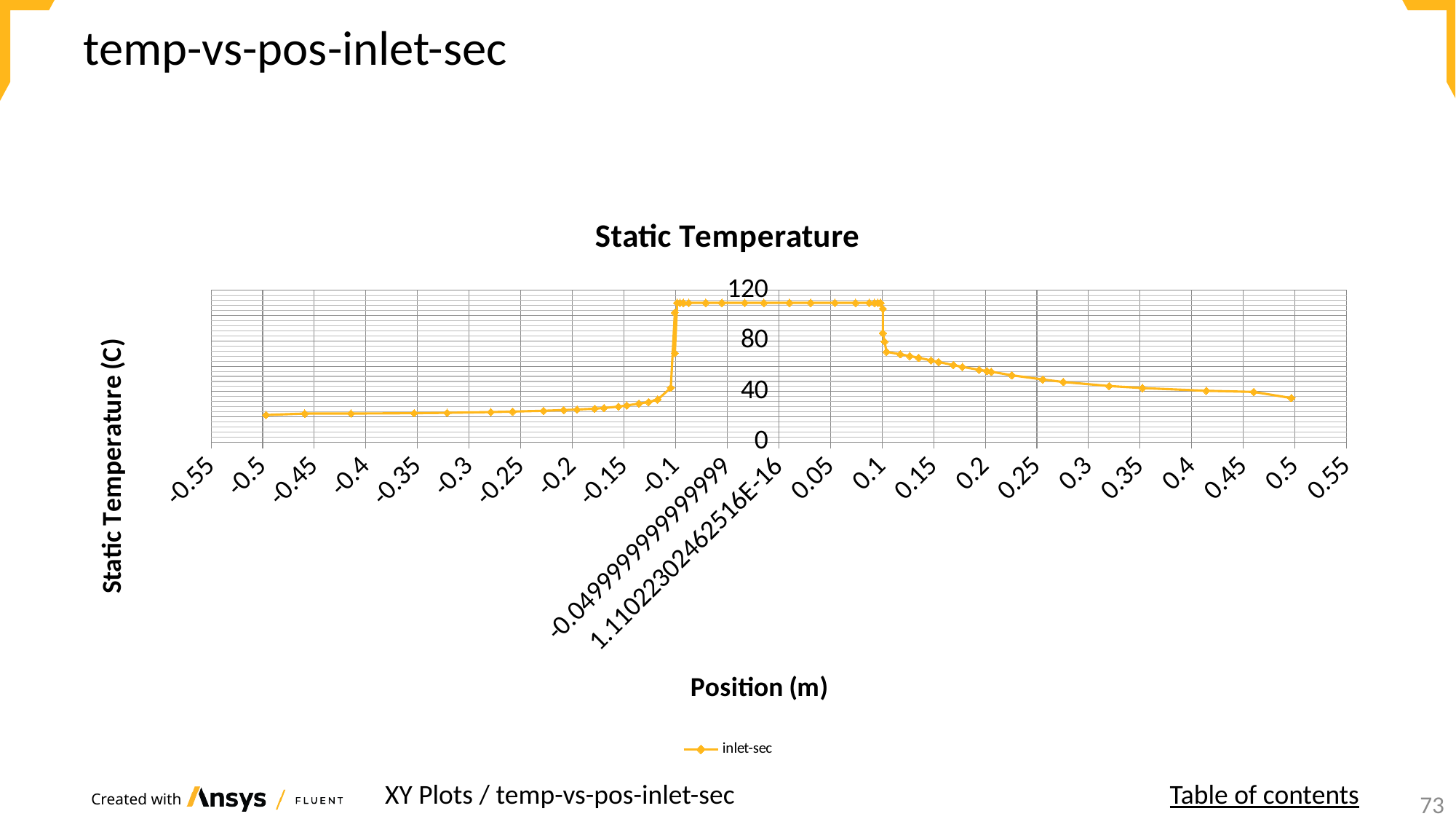
How many series does the legend list? 1 Is the value for inlet-sec at position 0.05 greater or less than 80? greater Is the value for inlet-sec at position 0.15 greater or less than 40? greater Is the value for inlet-sec at position -0.5 greater or less than 40? less What is the title of the chart? Static Temperature Do the values for inlet-sec rise or fall as position increases from -0.5 to -0.1? rise What is the name of the series shown in the legend? inlet-sec What kind of chart is shown on the slide? line chart Which is larger for inlet-sec: the value at position 0.05 or the value at position -0.3? 0.05 Do the values for inlet-sec rise or fall as position increases from 0.1 to 0.5? fall